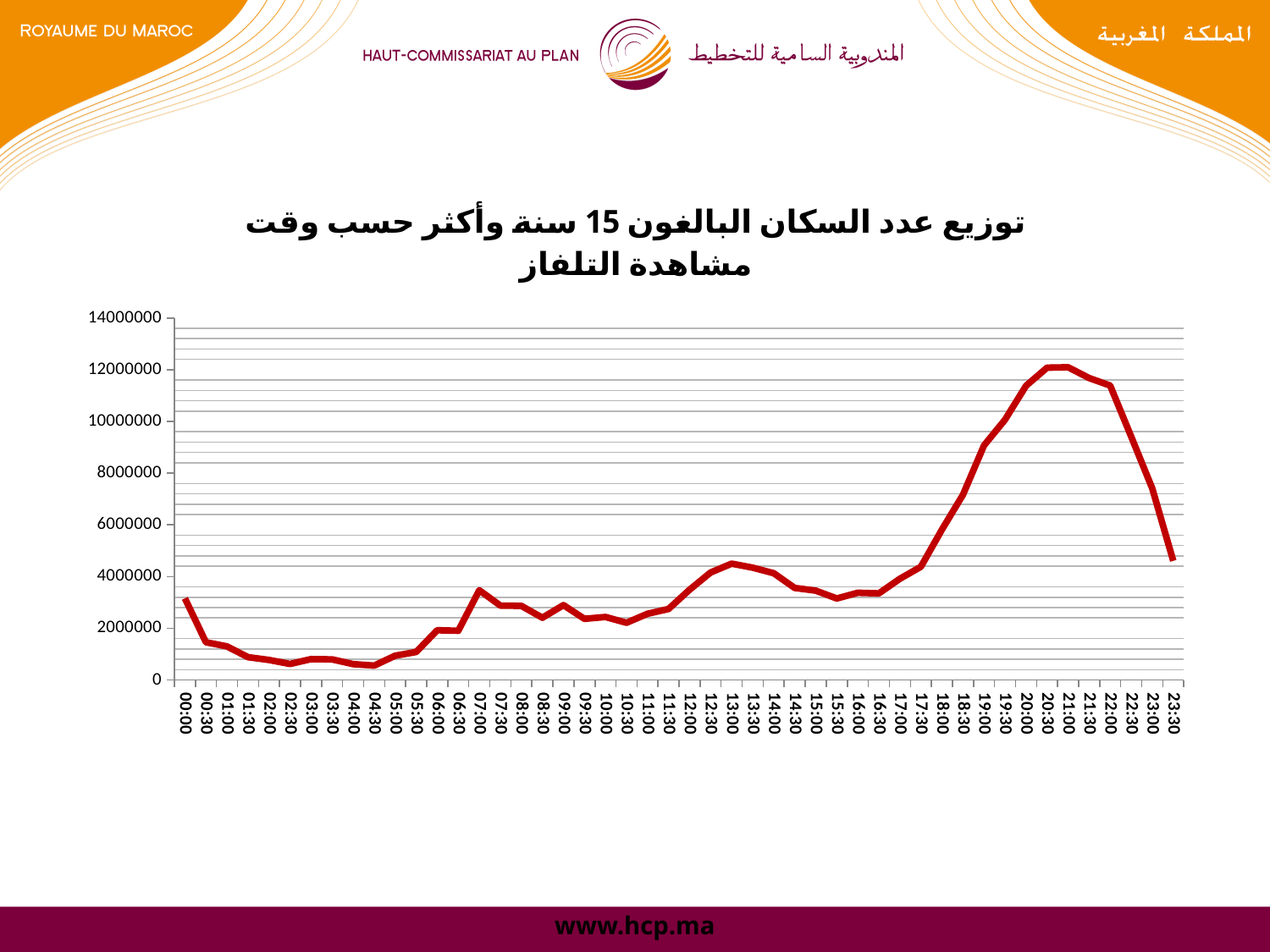
Is the value at 20:30 greater or less than 10000000? greater Is the value at 19:00 greater or less than 10000000? less Do the values rise or fall between 17:00 and 20:30? rise How many time points are plotted along the x axis? 48 What is the highest value shown on the y axis? 14000000 What kind of chart is shown on the slide? line chart Is the value at 00:00 greater or less than 2000000? greater Which has the larger value, 13:00 or 10:30? 13:00 Which has the larger value, 20:30 or 00:00? 20:30